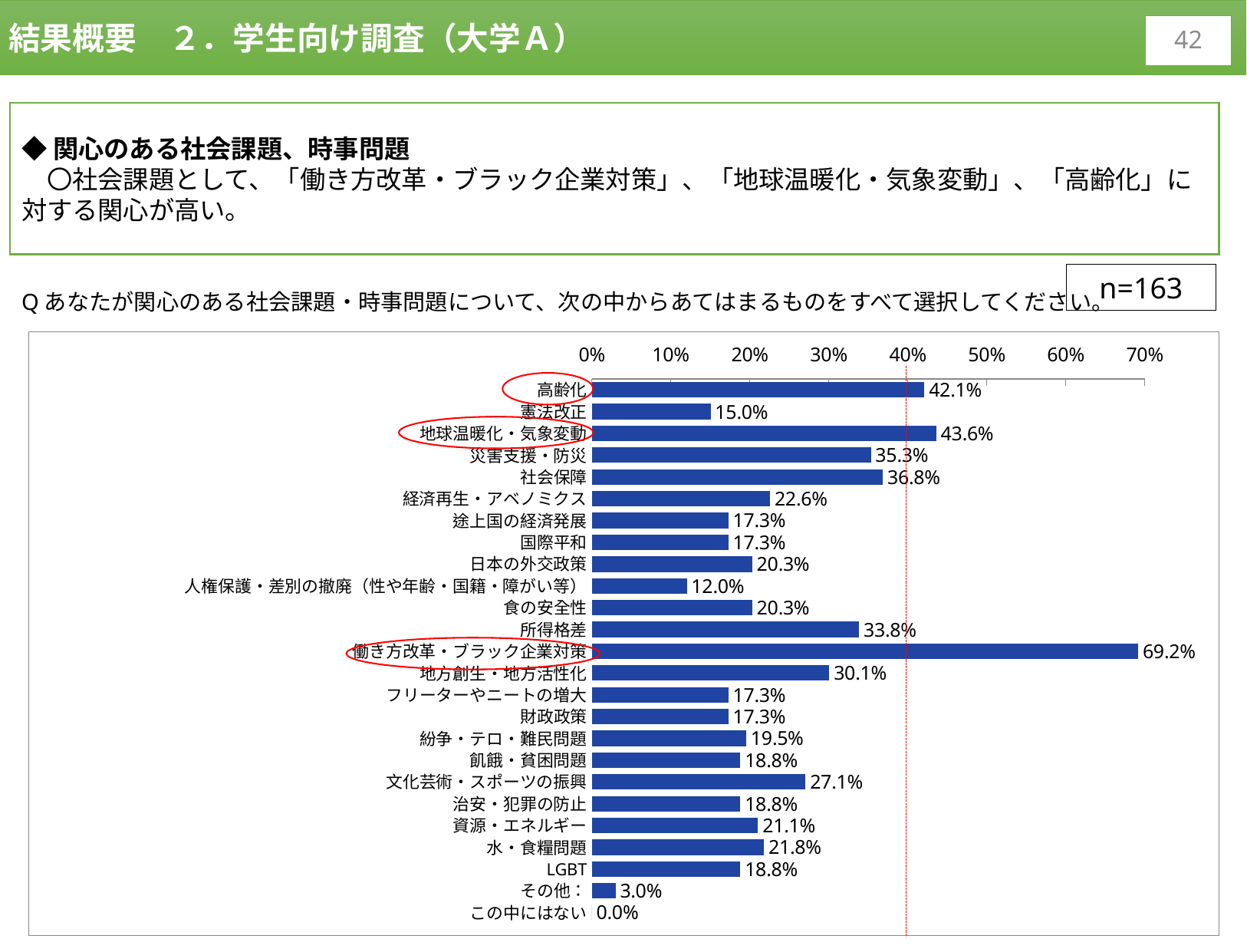
What is the value for 高齢化? 42.1% What is the difference between the values for 働き方改革・ブラック企業対策 and 地球温暖化・気象変動? 25.6% What kind of chart is shown on the slide? bar chart Is the value for 所得格差 greater or less than 30%? greater Which category has the lowest value? この中にはない What is the value for 人権保護・差別の撤廃（性や年齢・国籍・障がい等）? 12.0% Which is larger, the value for 社会保障 or the value for 災害支援・防災? 社会保障 Which category has the highest value? 働き方改革・ブラック企業対策 How many categories are shown in the chart? 25 What is the value for 地球温暖化・気象変動? 43.6% What is the value for 働き方改革・ブラック企業対策? 69.2% What is the sample size (n) shown for the survey? n=163